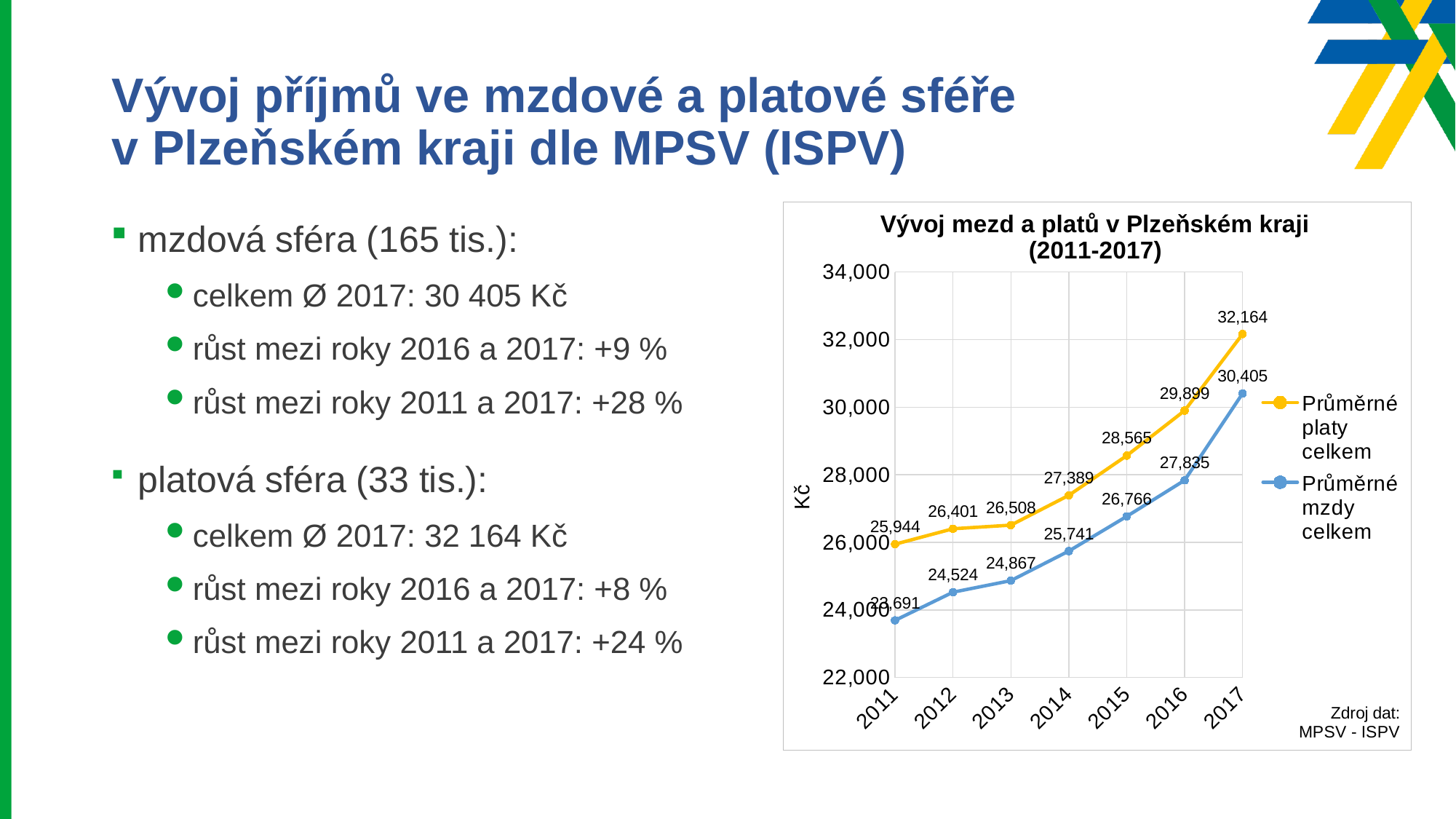
Is the value for Průměrné mzdy celkem in 2011 greater or less than 24,000? less In which year is Průměrné mzdy celkem lowest? 2011 What is the value of Průměrné mzdy celkem in 2017? 30,405 How many series does the legend list? 2 What type of chart is shown on the slide? line chart Which is larger in 2016: Průměrné platy celkem or Průměrné mzdy celkem? Průměrné platy celkem In which year is Průměrné platy celkem highest? 2017 What is the value of Průměrné platy celkem in 2014? 27,389 What is the value of Průměrné platy celkem in 2017? 32,164 What is the difference between Průměrné platy celkem and Průměrné mzdy celkem in 2017? 1,759 What is the value of Průměrné mzdy celkem in 2015? 26,766 Do the values of Průměrné platy celkem rise or fall from 2011 to 2017? rise